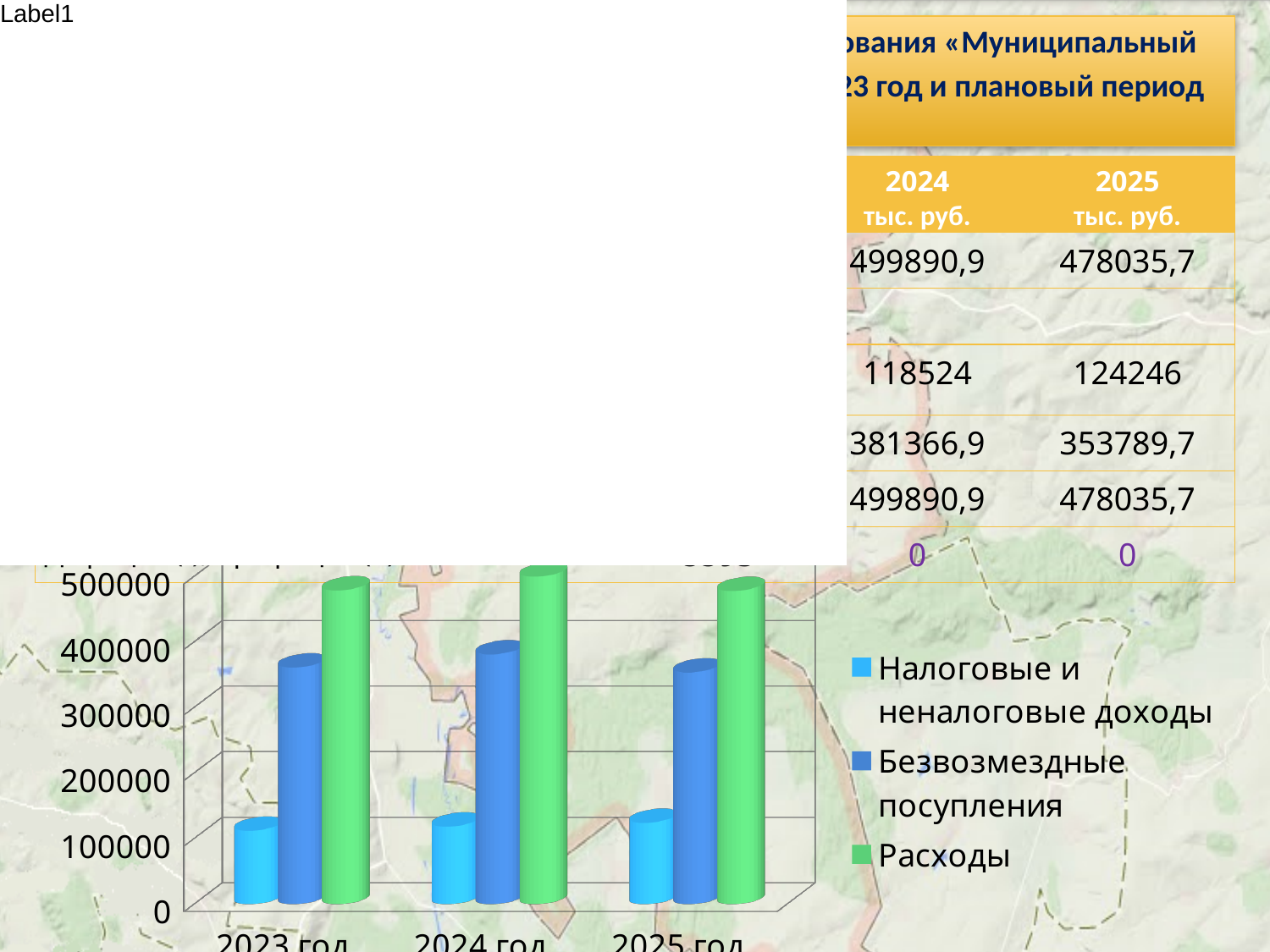
Which series is shown in light blue in the chart? Налоговые и неналоговые доходы Which series has the lowest bar for 2023 год? Налоговые и неналоговые доходы Is the value for Налоговые и неналоговые доходы in 2025 год greater or less than 200000? less Which series has the highest bar for 2024 год? Расходы Which is larger in 2025 год: Расходы or Налоговые и неналоговые доходы? Расходы What kind of chart is shown on the slide? bar chart Which series is shown in green in the chart? Расходы Is the value for Расходы in 2023 год greater or less than 400000? greater Which is larger in 2023 год: Безвозмездные посупления or Налоговые и неналоговые доходы? Безвозмездные посупления Is the value for Безвозмездные посупления in 2024 год greater or less than 300000? greater How many series does the chart legend list? 3 How many year categories are shown on the x axis of the chart? 3